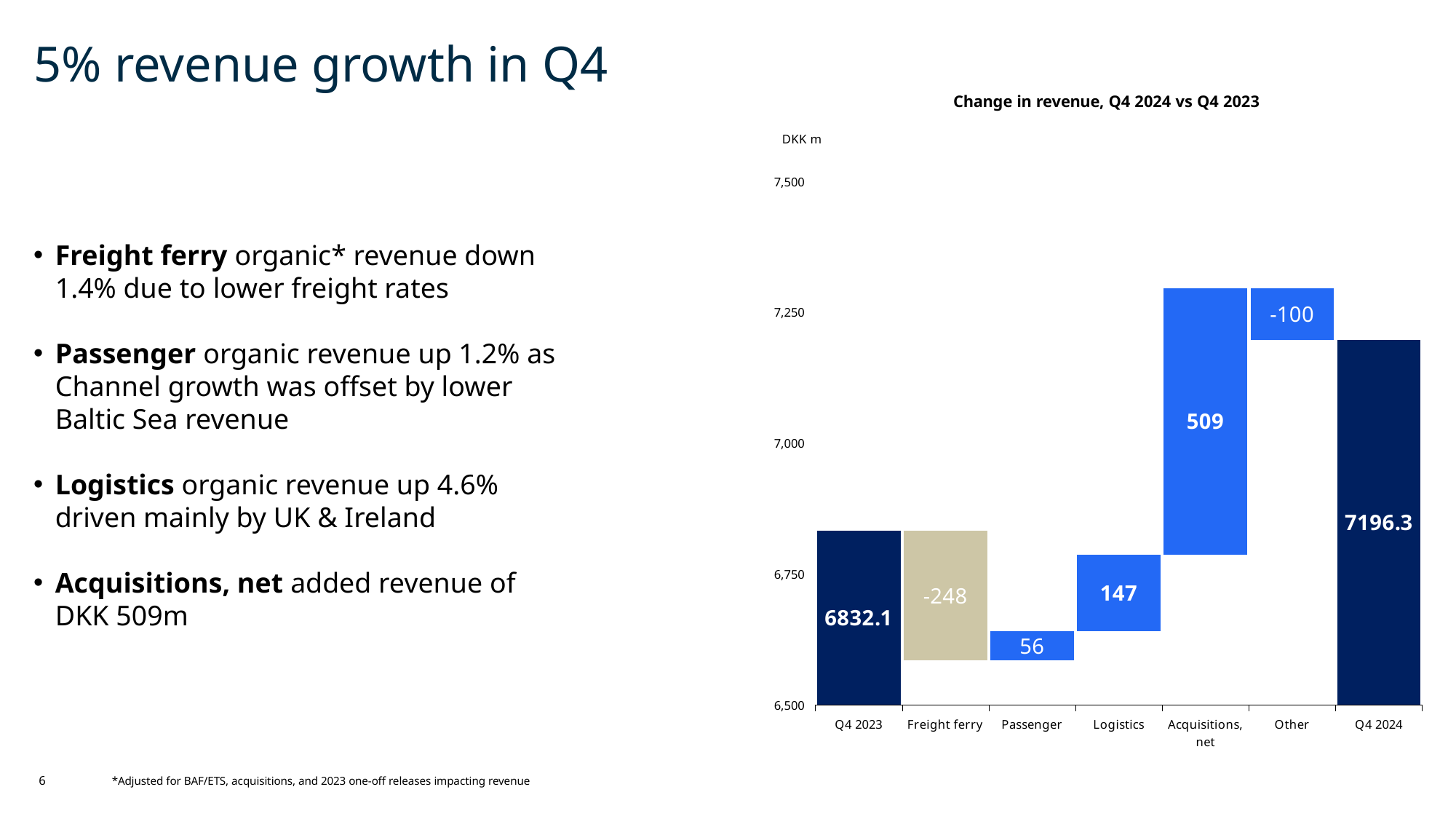
What is the change in revenue attributed to Freight ferry? -248 Which change category has the most negative value? Freight ferry What is the change in revenue attributed to Other? -100 What is the revenue value shown for Q4 2024? 7196.3 What is the change in revenue attributed to Acquisitions, net? 509 What type of chart is shown on the slide? Waterfall bar chart Which change category contributes the largest positive amount to revenue? Acquisitions, net What is the difference between the Q4 2024 and Q4 2023 revenue values? 364.2 What is the revenue value shown for Q4 2023? 6832.1 How many categories are shown on the x axis of the chart? 7 Which is larger, the change for Logistics or the change for Passenger? Logistics What is the title of the chart? Change in revenue, Q4 2024 vs Q4 2023